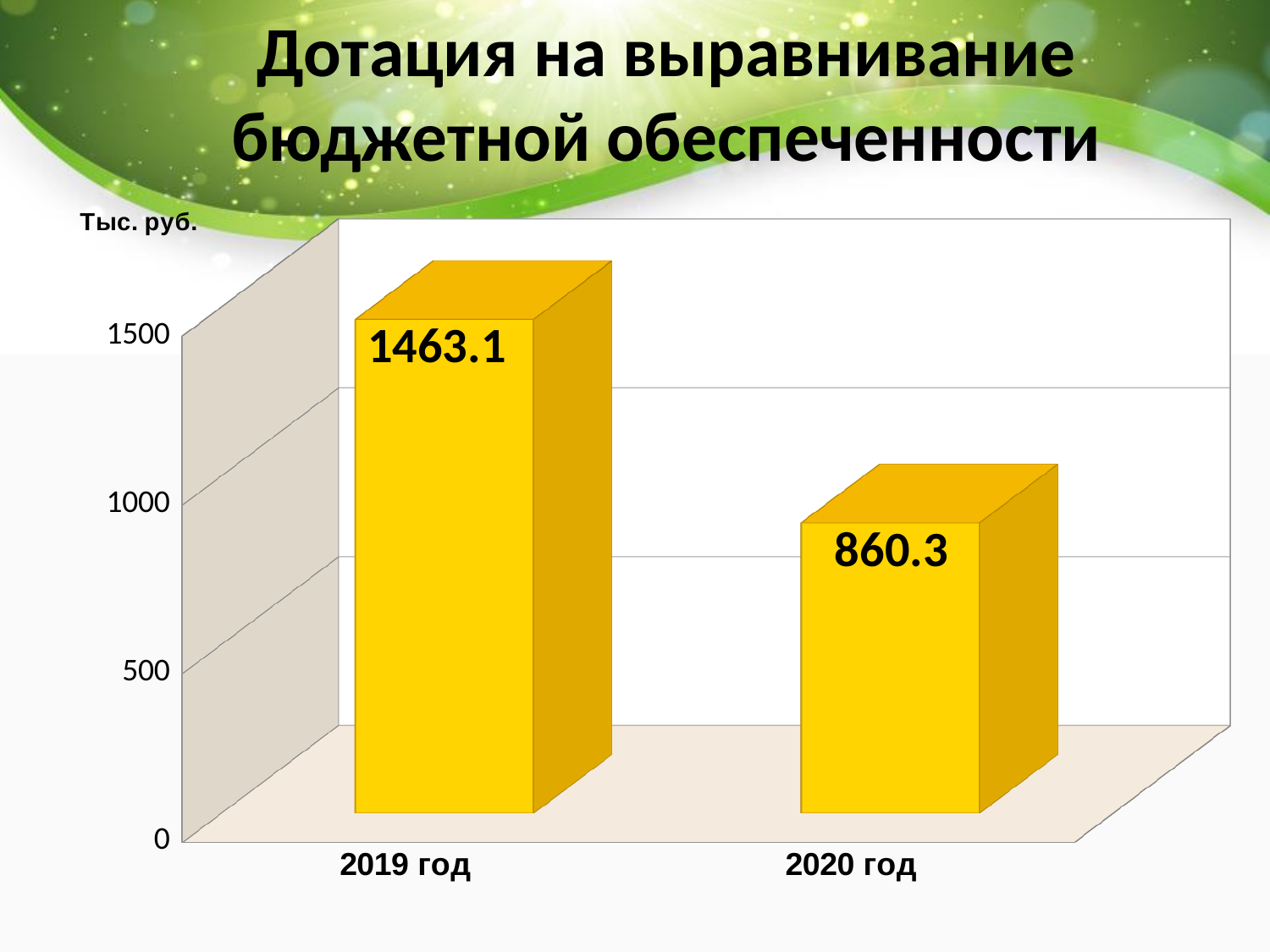
Is the value for 2019 год greater or less than 1000? greater Which year has the lowest value? 2020 год Which year has the highest value? 2019 год What is the value for 2020 год? 860.3 What is the difference between the values for 2019 год and 2020 год? 602.8 How many categories are shown on the chart? 2 Do the values rise or fall from 2019 год to 2020 год? fall What kind of chart is shown on the slide? bar chart Which is larger, the value for 2019 год or for 2020 год? 2019 год What unit is indicated for the values on the chart? Тыс. руб. Is the value for 2020 год greater or less than 1000? less What is the value for 2019 год? 1463.1